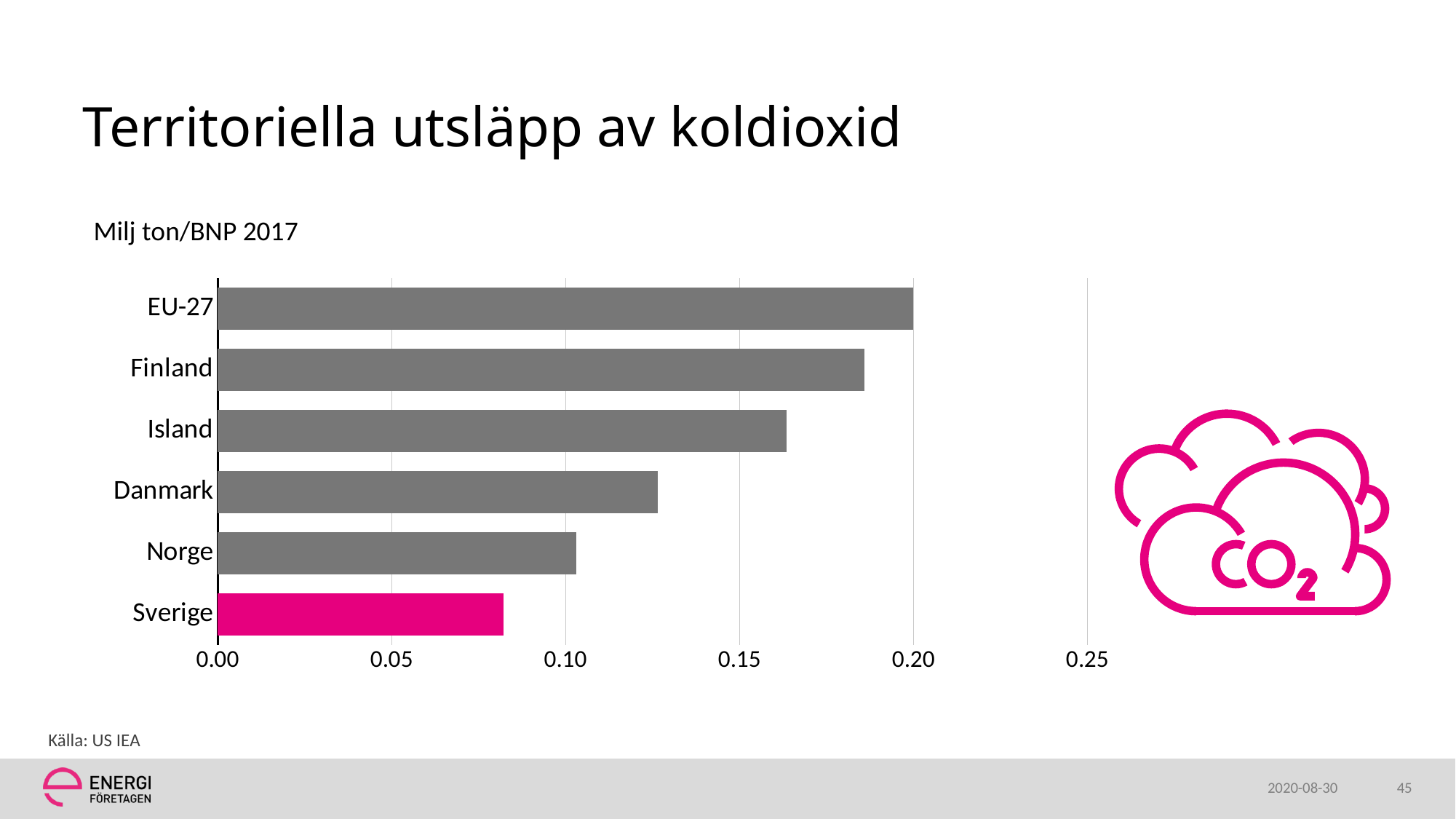
Is the value for Island greater or less than 0.20? less Is the value for Danmark greater or less than 0.10? greater Which category has the lowest value in the chart? Sverige Which has a larger value, Norge or Island? Island Which category's bar is shown in a different colour (pink) from the others? Sverige How many categories are plotted in the chart? 6 Is the value for Sverige greater or less than 0.10? less Which category has the highest value in the chart? EU-27 Which has a larger value, Finland or Danmark? Finland What kind of chart is shown on the slide? bar chart